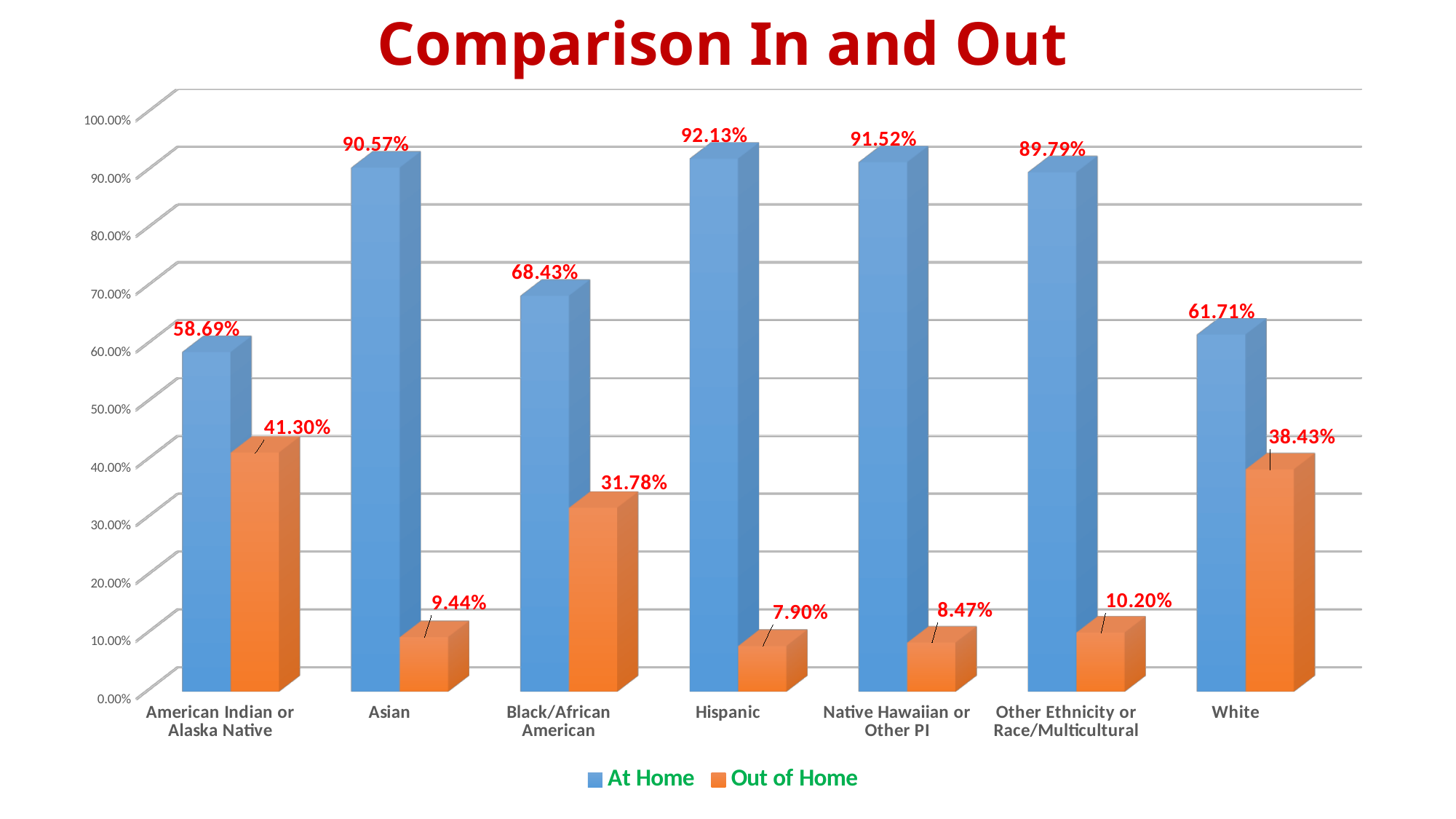
How many series does the legend list? 2 What is the At Home value for Hispanic? 92.13% Which category has the lowest Out of Home value? Hispanic Which is larger: the Out of Home value for American Indian or Alaska Native or the Out of Home value for White? American Indian or Alaska Native Which category has the highest At Home value? Hispanic Which category has the lowest At Home value? American Indian or Alaska Native How many categories are shown on the x axis? 7 What is the Out of Home value for Asian? 9.44% What is the difference between the At Home and Out of Home values for Black/African American? 36.65% What is the title of the chart? Comparison In and Out What kind of chart is shown on the slide? Bar chart What is the Out of Home value for White? 38.43%